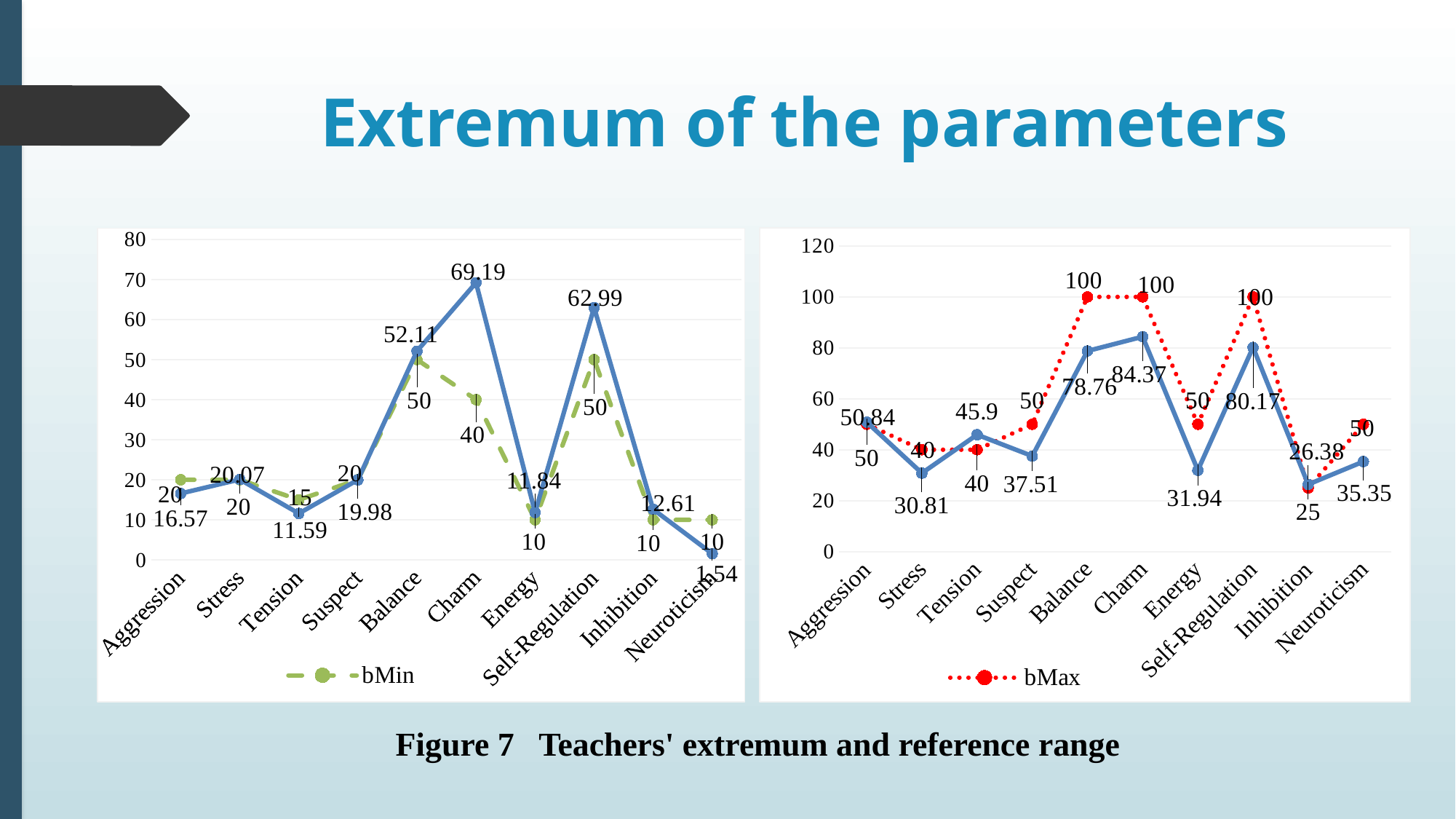
In the left chart, what is the bMin value for Balance? 50 In the right chart, what is the value of the solid blue line for Charm? 84.37 In the right chart, which category has the lowest bMax value? Inhibition In the left chart, how many categories are shown on the x axis? 10 In the left chart, which category has the lowest value on the solid blue line? Neuroticism In the right chart, is the solid blue line value for Self-Regulation greater or less than the bMax value for Self-Regulation? less In the right chart, what is the difference between the bMax value and the solid blue line value for Balance? 21.24 What kind of chart is the left chart on the slide? line chart In the right chart, what is the bMax value for Inhibition? 25 In the left chart, what is the bMin value for Charm? 40 In the left chart, what is the value of the solid blue line for Charm? 69.19 What series name is shown in the legend of the right chart? bMax